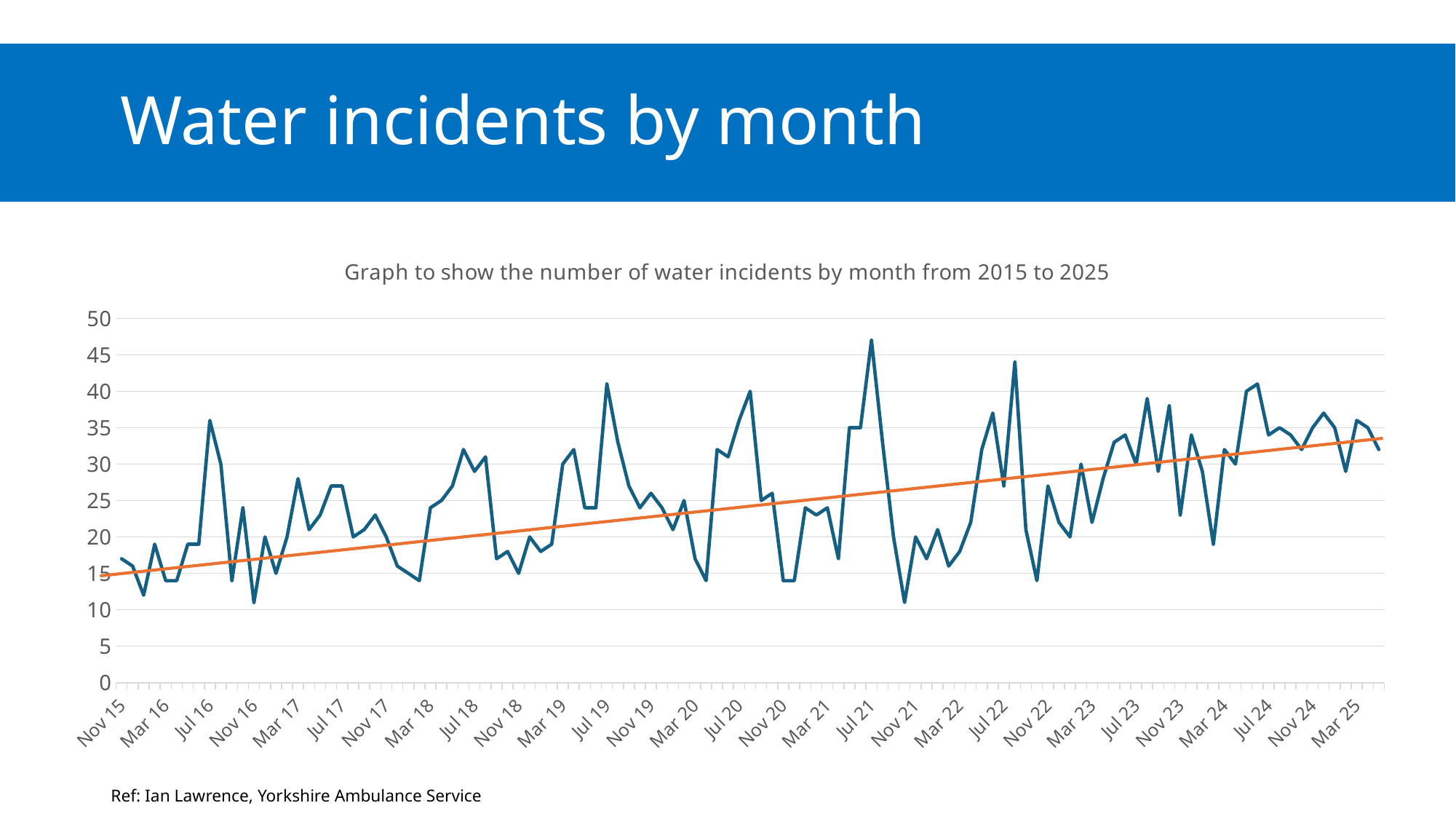
In which year does the line reach its highest peak? 2021 Is the highest peak of the line, around mid-2021, greater or less than 45? greater Is the value of the orange trend line at Mar 25 greater or less than 30? greater What is the maximum value shown on the vertical axis? 50 Overall, do the monthly water incident values rise or fall from 2015 to 2025? Rise Is the value of the orange trend line at Nov 15 greater or less than 20? less What kind of chart is shown on the slide? Line chart What is the title of the chart? Graph to show the number of water incidents by month from 2015 to 2025 Does the orange trend line rise or fall from left to right across the chart? Rises